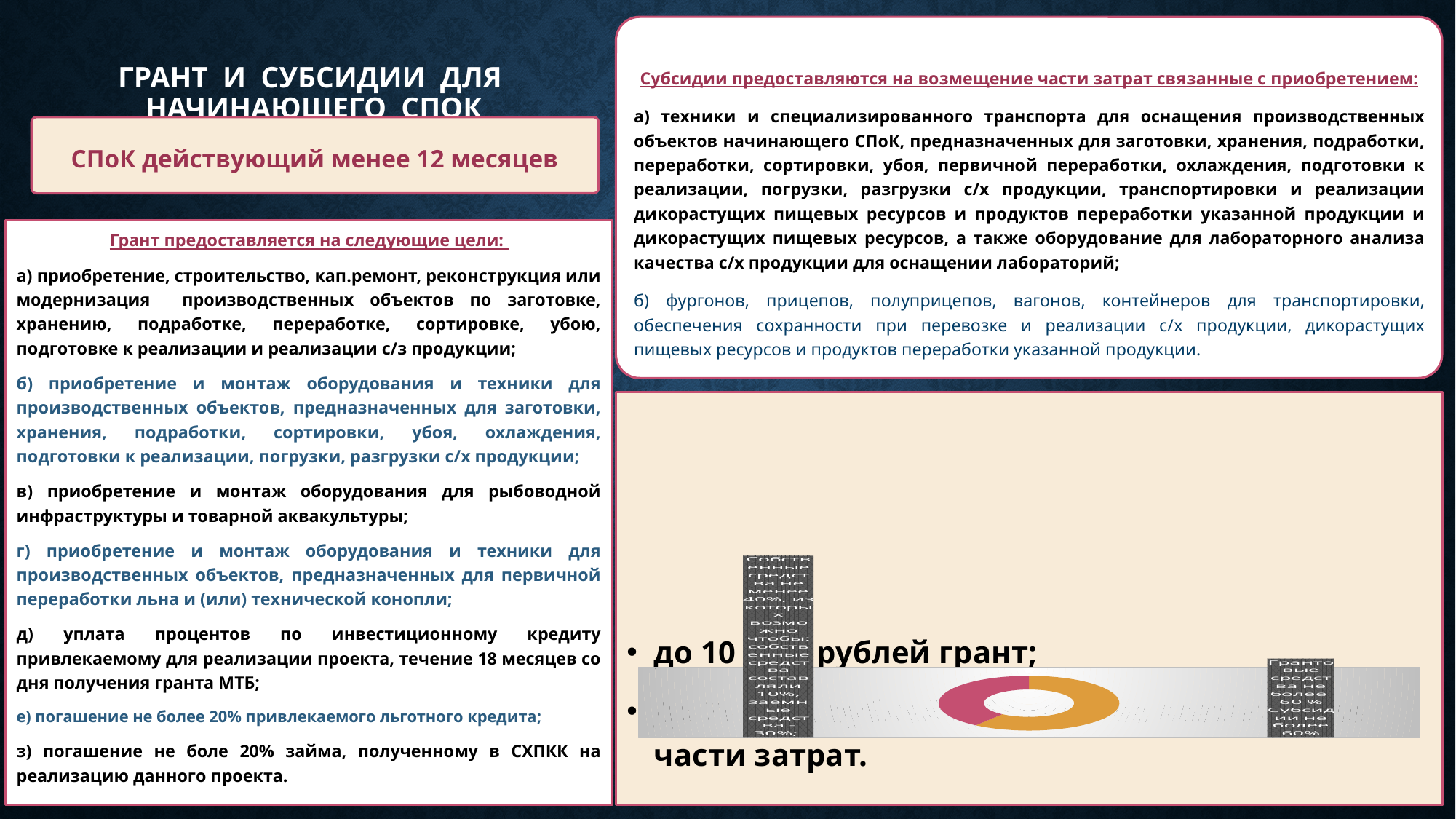
In the doughnut chart in the bottom-right panel, is the orange slice greater or less than half of the ring? greater In the doughnut chart in the bottom-right panel, which slice is larger, the pink one or the orange one? The orange one What two colours are used for the slices of the doughnut chart in the bottom-right panel? Pink and orange How many slices does the doughnut chart in the bottom-right panel have? 2 In the doughnut chart in the bottom-right panel, which slice is the smallest? The pink slice What kind of chart is shown in the bottom-right panel of the slide? Doughnut (pie) chart In the doughnut chart in the bottom-right panel, is the pink slice greater or less than half of the ring? less